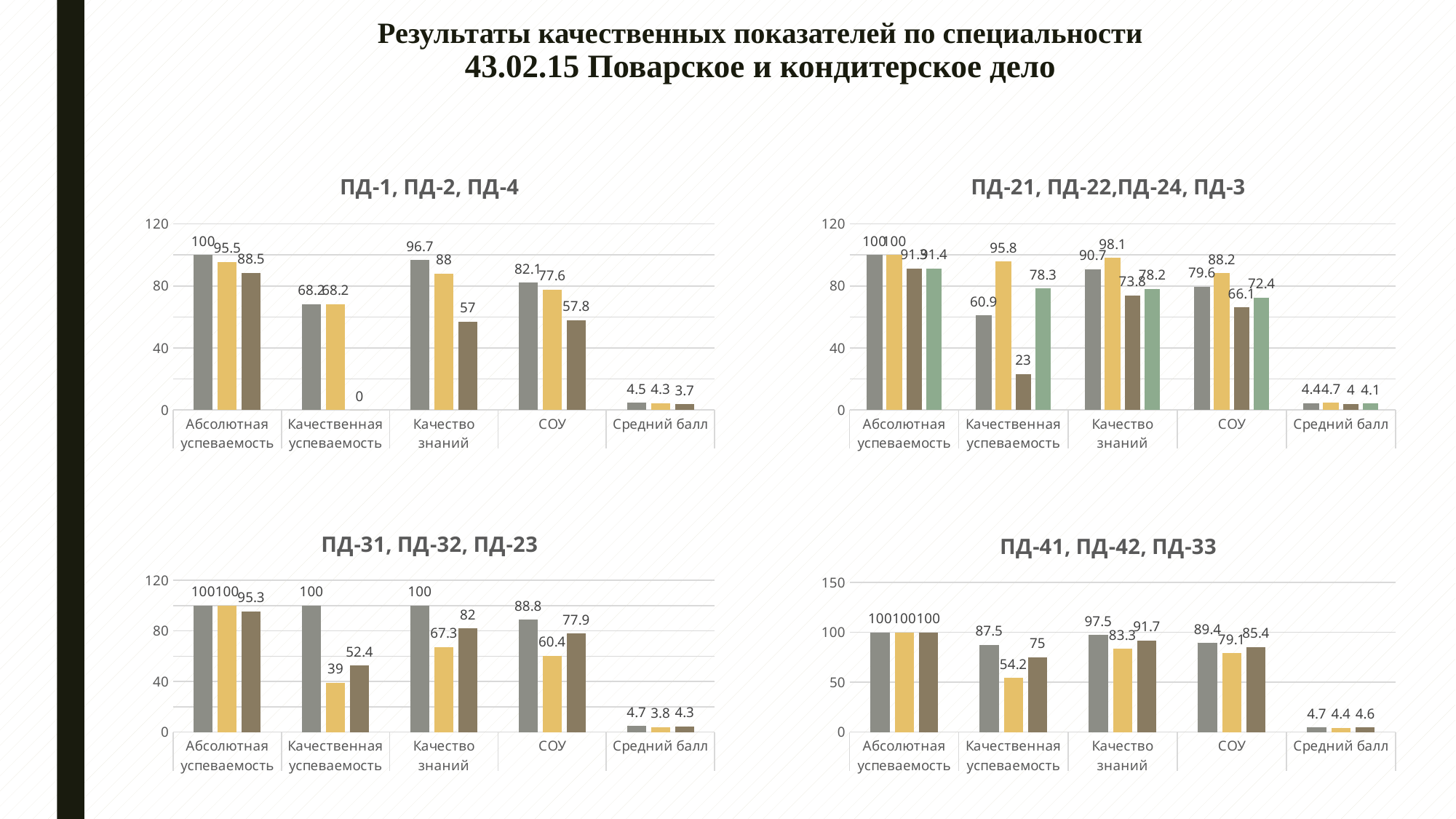
In the chart titled 'ПД-1, ПД-2, ПД-4', what is the value of the third bar for 'Качественная успеваемость'? 0 What type of chart is the chart titled 'ПД-31, ПД-32, ПД-23'? bar chart In the chart titled 'ПД-31, ПД-32, ПД-23', which is larger for 'СОУ': the second (yellow) bar or the third (dark brown) bar? the third (dark brown) bar, 77.9 In the chart titled 'ПД-41, ПД-42, ПД-33', what is the value of the third bar for 'Средний балл'? 4.6 In the chart titled 'ПД-41, ПД-42, ПД-33', what is the difference between the first and second bars for 'Качественная успеваемость'? 33.3 In the chart titled 'ПД-21, ПД-22,ПД-24, ПД-3', which bar has the lowest value for 'Качественная успеваемость'? the third (dark brown) bar, 23 In the chart titled 'ПД-21, ПД-22,ПД-24, ПД-3', how many bars are shown for each category? 4 In the chart titled 'ПД-31, ПД-32, ПД-23', what is the difference between the first and second bars for 'Качественная успеваемость'? 61 How many categories are shown on the x axis of the chart titled 'ПД-41, ПД-42, ПД-33'? 5 In the chart titled 'ПД-1, ПД-2, ПД-4', what is the value of the third (dark brown) bar for 'Качество знаний'? 57 In the chart titled 'ПД-21, ПД-22,ПД-24, ПД-3', what is the value of the second (yellow) bar for 'Качество знаний'? 98.1 How many charts are shown on the slide? 4